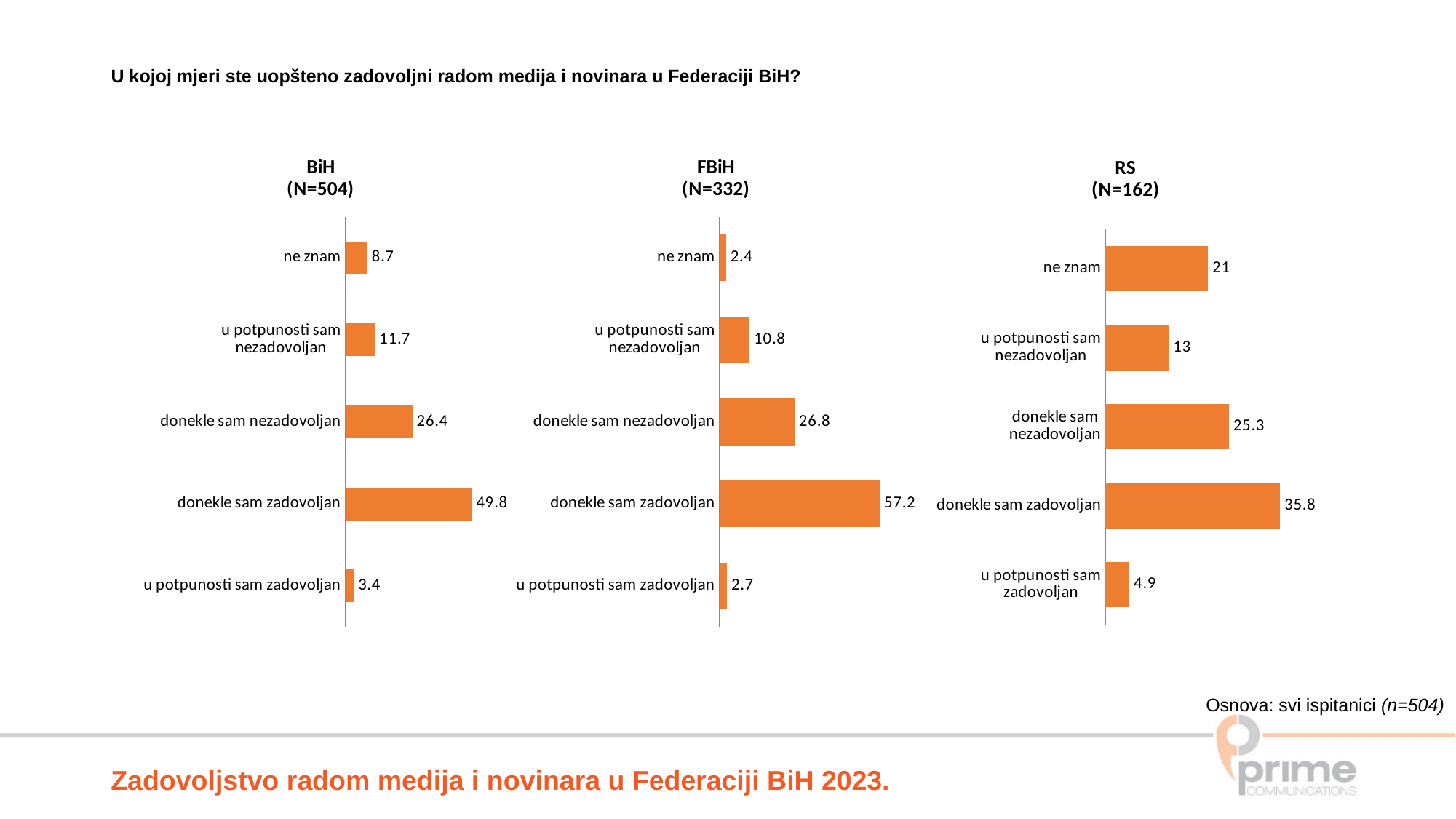
What is the sample size (N) shown in the title of the RS chart? N=162 In the BiH (N=504) chart, which category has the lowest value? u potpunosti sam zadovoljan In the RS (N=162) chart, which is larger: 'ne znam' or 'u potpunosti sam nezadovoljan'? ne znam In the RS (N=162) chart, what is the value for 'u potpunosti sam nezadovoljan'? 13 In the FBiH (N=332) chart, what is the value for 'ne znam'? 2.4 How many charts are shown on the slide? 3 How many categories are shown in the FBiH (N=332) chart? 5 In the RS (N=162) chart, which category has the highest value? donekle sam zadovoljan What kind of chart is the BiH (N=504) chart? bar chart In the FBiH (N=332) chart, what is the difference between 'donekle sam zadovoljan' and 'donekle sam nezadovoljan'? 30.4 In the BiH (N=504) chart, what is the value for 'donekle sam zadovoljan'? 49.8 In the RS (N=162) chart, what is the difference between 'donekle sam zadovoljan' and 'donekle sam nezadovoljan'? 10.5